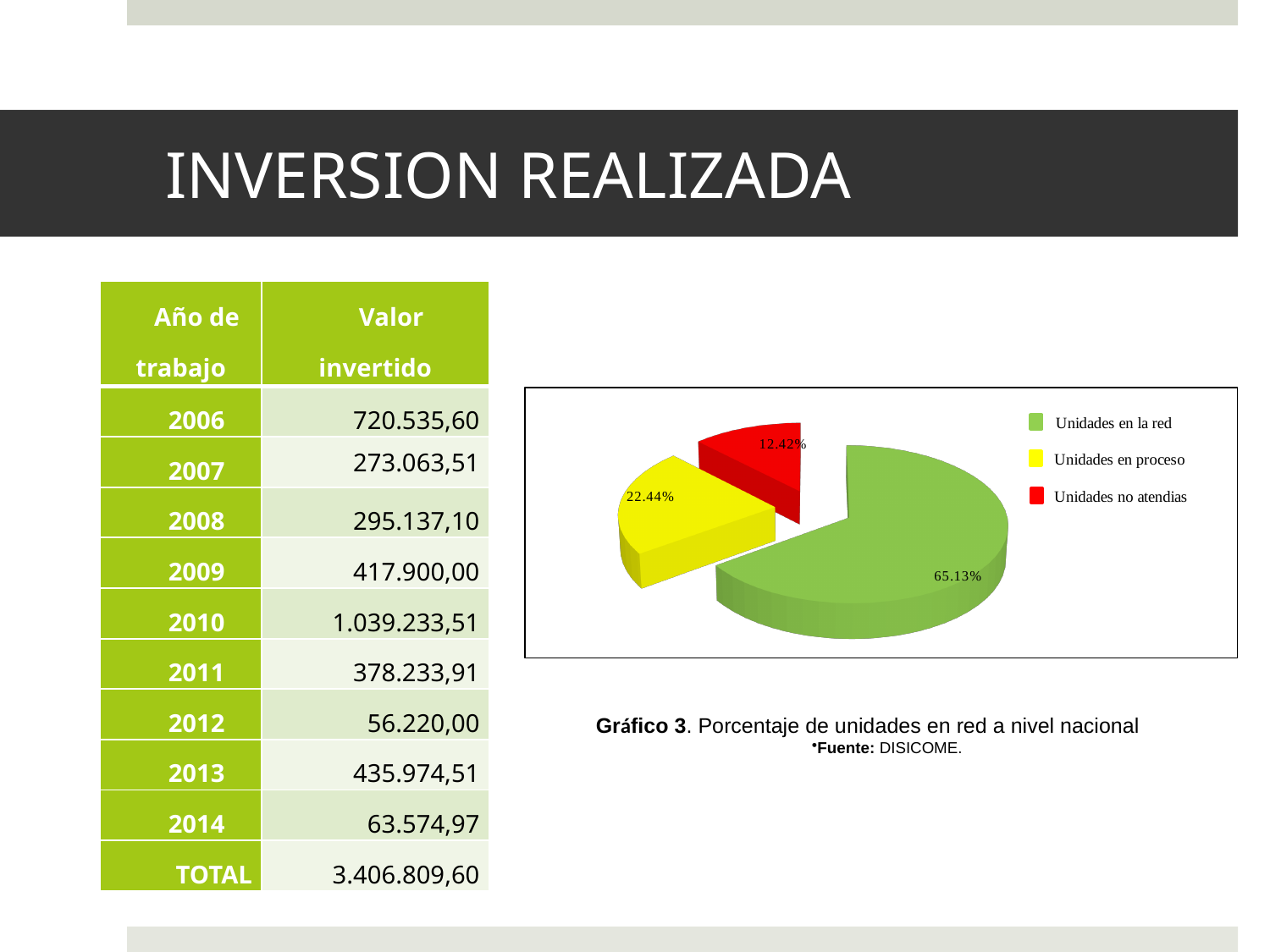
What colour is the Unidades no atendias slice in the pie chart? red What percentage of the pie chart is labelled for Unidades en proceso? 22.44% Which is larger in the pie chart, Unidades en proceso or Unidades no atendias? Unidades en proceso How many slices does the pie chart have? 3 What colour is the Unidades en proceso slice in the pie chart? yellow What kind of chart is shown on the slide? pie chart What percentage of the pie chart is labelled for Unidades no atendias? 12.42% Which category has the largest slice in the pie chart? Unidades en la red Which category has the smallest slice in the pie chart? Unidades no atendias How many entries does the legend of the pie chart list? 3 What is the difference in percentage points between the Unidades en la red slice and the Unidades en proceso slice? 42.69 What percentage of the pie chart is labelled for Unidades en la red? 65.13%